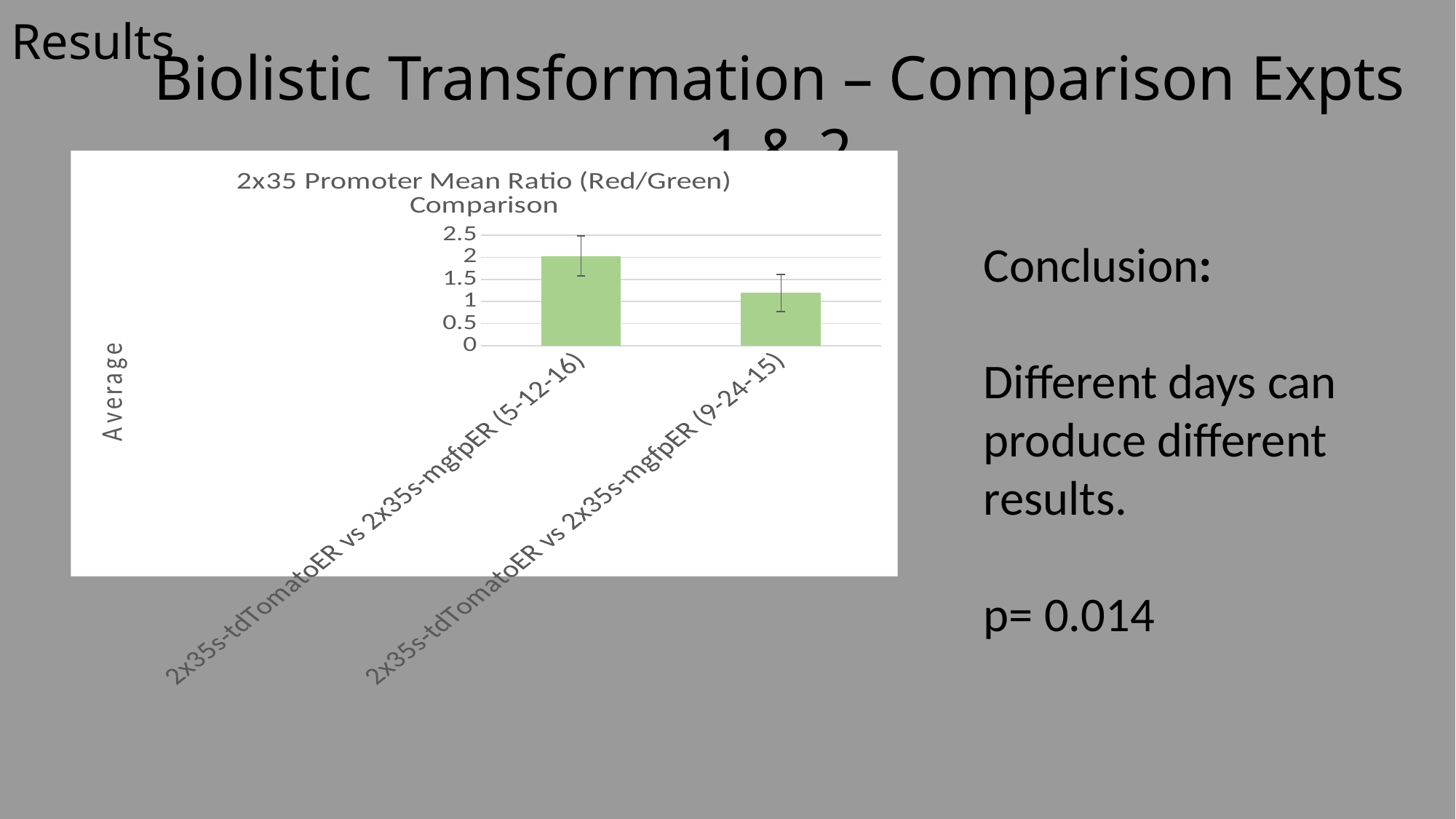
Is the value for 2x35s-tdTomatoER vs 2x35s-mgfpER (9-24-15) greater or less than 1? greater Do the bar values rise or fall from left to right along the x axis? fall What type of chart is shown on the slide? bar chart What is the title of the chart? 2x35 Promoter Mean Ratio (Red/Green) Comparison Is the value for 2x35s-tdTomatoER vs 2x35s-mgfpER (9-24-15) greater or less than 1.5? less How many bars (categories) are plotted in the chart? 2 Which is larger: the value for the (5-12-16) experiment or the (9-24-15) experiment? 2x35s-tdTomatoER vs 2x35s-mgfpER (5-12-16) Which category has the highest bar in the chart? 2x35s-tdTomatoER vs 2x35s-mgfpER (5-12-16) What is the label on the vertical axis of the chart? Average Which category has the lowest bar in the chart? 2x35s-tdTomatoER vs 2x35s-mgfpER (9-24-15) Is the value for 2x35s-tdTomatoER vs 2x35s-mgfpER (5-12-16) greater or less than 1.5? greater